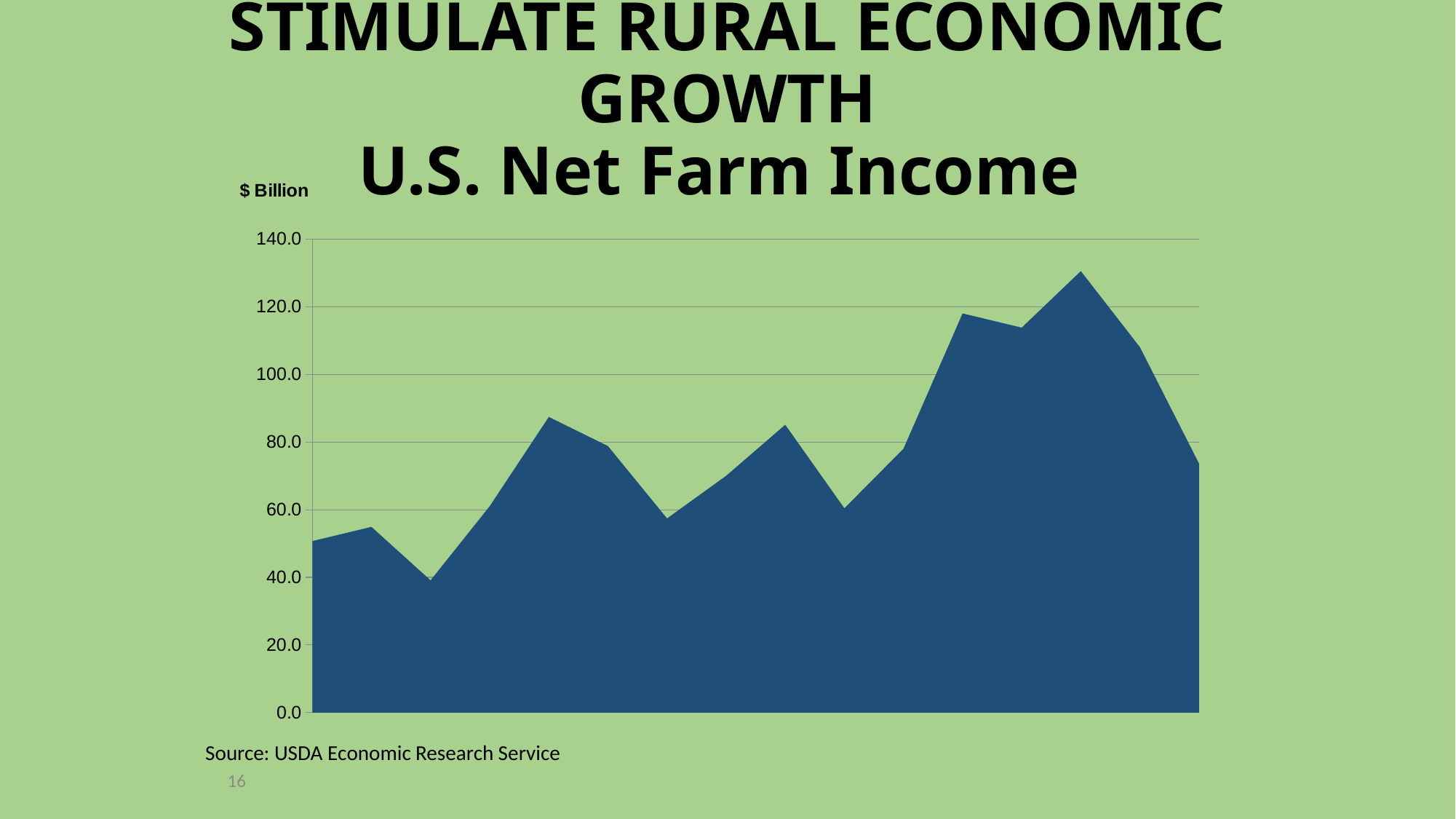
What is the title of the chart? U.S. Net Farm Income Does the U.S. Net Farm Income chart rise or fall from its peak to the final point? fall Is the highest point of the U.S. Net Farm Income chart greater or less than 120? greater Is the first value plotted on the U.S. Net Farm Income chart greater or less than 60? less Is the last value plotted on the U.S. Net Farm Income chart greater or less than 60? greater What kind of chart is shown on the slide? area chart What unit is shown for the vertical axis of the chart? $ Billion Is the last value on the U.S. Net Farm Income chart higher or lower than the first value? higher